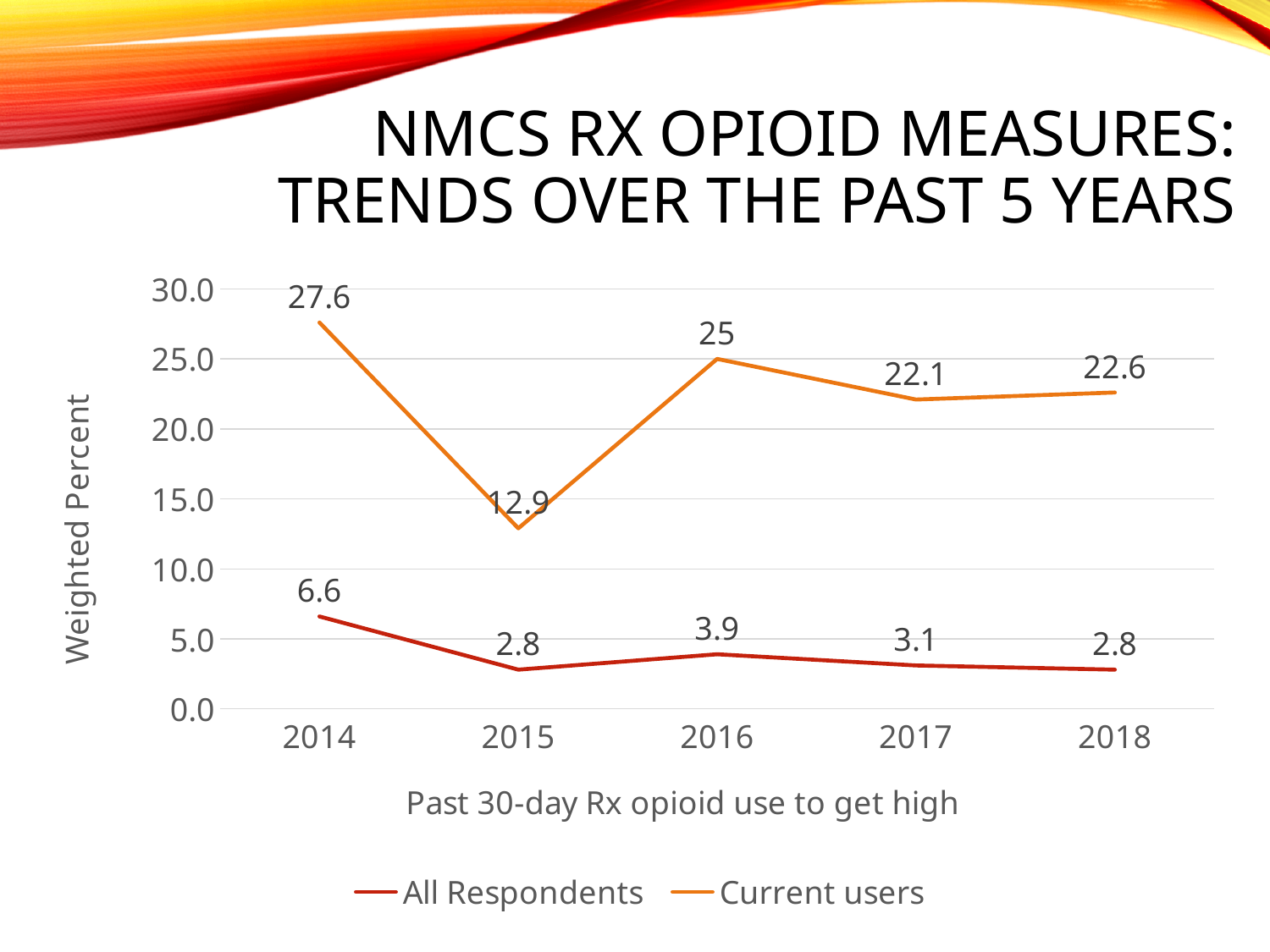
How many series does the legend list? 2 Is the Current users value in 2016 greater or less than 20.0? greater What is the value for Current users in 2018? 22.6 In which year is the All Respondents value highest? 2014 What is the label of the y axis? Weighted Percent What kind of chart is shown on the slide? Line chart In which year is the Current users value lowest? 2015 How many years are shown on the x axis? 5 What is the value for All Respondents in 2016? 3.9 What is the value for Current users in 2014? 27.6 Which is larger: the All Respondents value in 2017 or in 2018? 2017 What is the difference between the Current users values in 2014 and 2015? 14.7